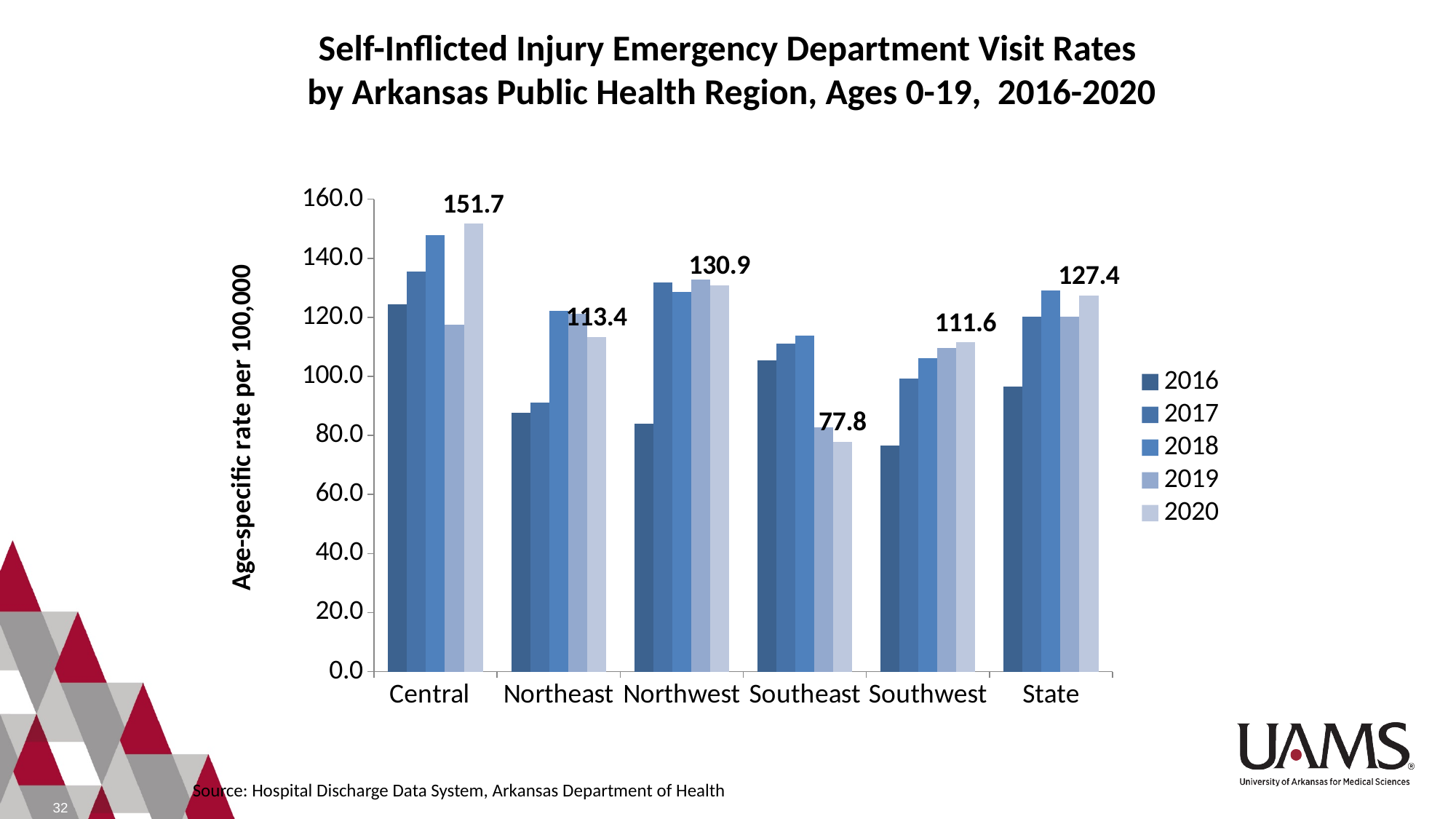
Which region has the highest 2020 value? Central Which is larger in 2020, the Northwest value or the State value? Northwest What is the 2020 value for the State? 127.4 Is the 2016 value for Northwest greater or less than 100? less Which region has the lowest 2020 value? Southeast How many series does the legend list? 5 What kind of chart is shown on the slide? bar chart What is the 2020 value for the Central region? 151.7 What is the difference between the 2020 values for Central and Southeast? 73.9 Is the 2018 value for Central greater or less than 140? greater What is the 2020 value for the Southeast region? 77.8 How many regions (categories) are shown on the x axis? 6